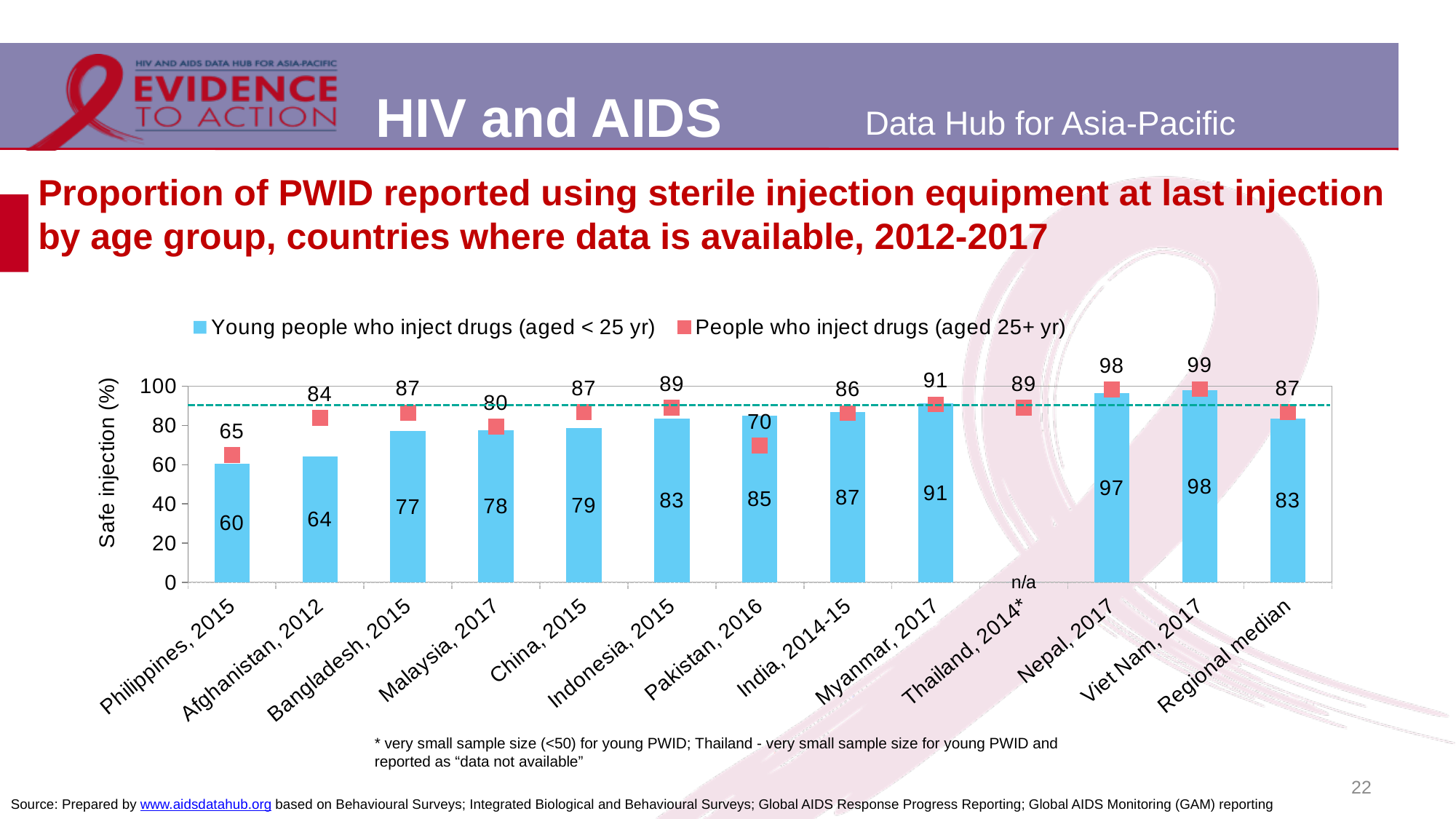
How many series does the legend list? 2 What is the regional median for young people who inject drugs (aged < 25 yr)? 83 Which is larger in Pakistan, 2016: the value for young people aged < 25 yr or the value for people aged 25+ yr? Young people who inject drugs (aged < 25 yr) How many categories are shown on the x axis of the chart? 13 What is the difference between the aged 25+ yr value and the aged < 25 yr value for Afghanistan, 2012? 20 Which country has the lowest value for young people who inject drugs (aged < 25 yr)? Philippines, 2015 Which category shows 'n/a' for young people who inject drugs (aged < 25 yr)? Thailand, 2014* What is the value for people who inject drugs (aged 25+ yr) in Pakistan, 2016? 70 What kind of chart is shown on the slide? Bar chart What is the label of the y axis? Safe injection (%) What is the value for young people who inject drugs (aged < 25 yr) in Nepal, 2017? 97 Which country has the highest value for young people who inject drugs (aged < 25 yr)? Viet Nam, 2017